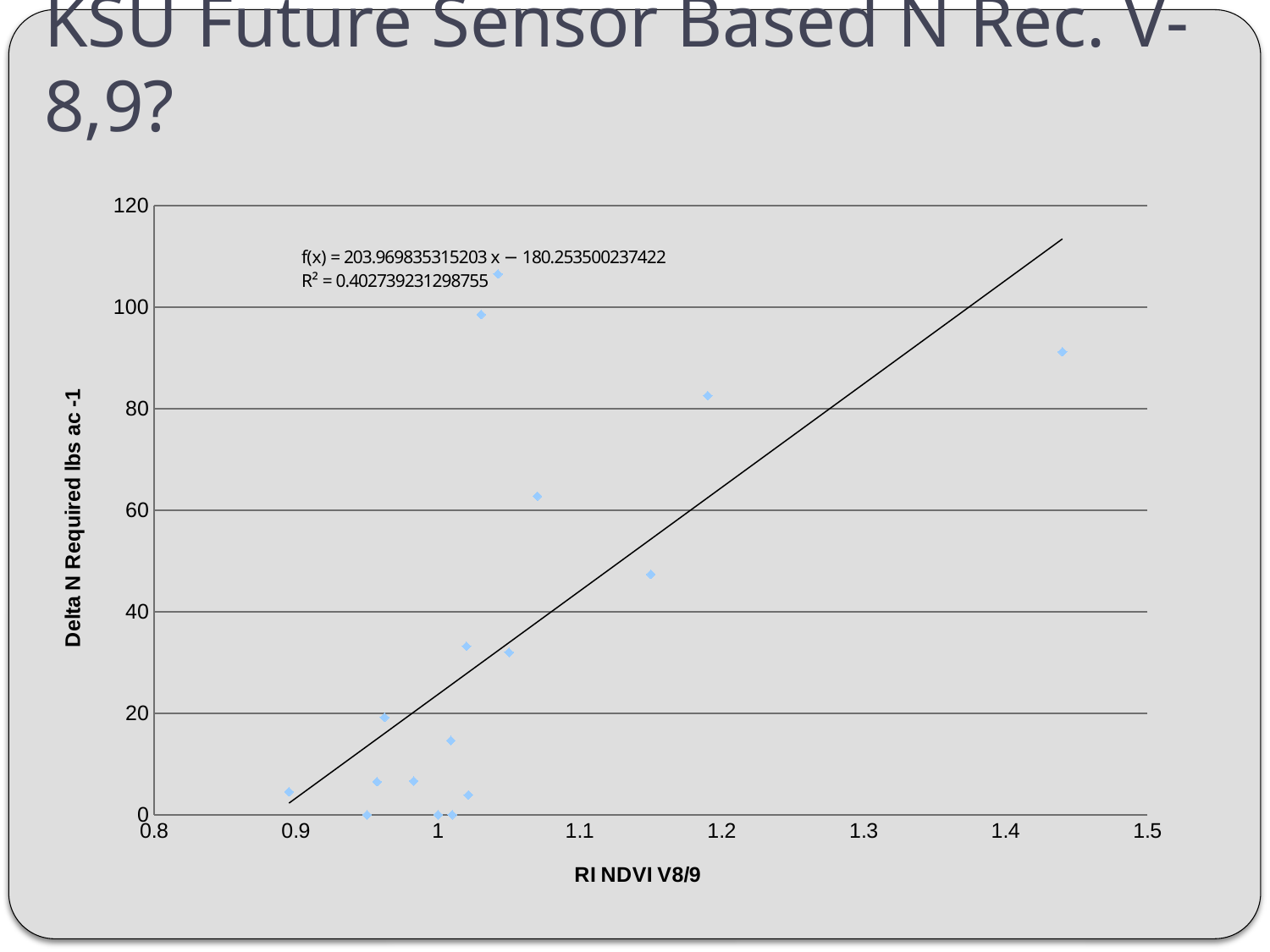
Which has the larger Delta N Required value: the point near RI NDVI 1.19 or the point near RI NDVI 1.15? The point near RI NDVI 1.19 Is the Delta N Required value for the leftmost point (near RI NDVI 0.9) greater or less than 20? less Do the plotted values generally rise or fall as RI NDVI V8/9 increases along the x axis? Rise Is the Delta N Required value for the highest plotted point greater or less than 100? greater Is the Delta N Required value for the point near RI NDVI 1.15 greater or less than 60? less What is the label of the x axis? RI NDVI V8/9 What kind of chart is shown on the slide? Scatter chart What is the R² value printed on the chart? R² = 0.402739231298755